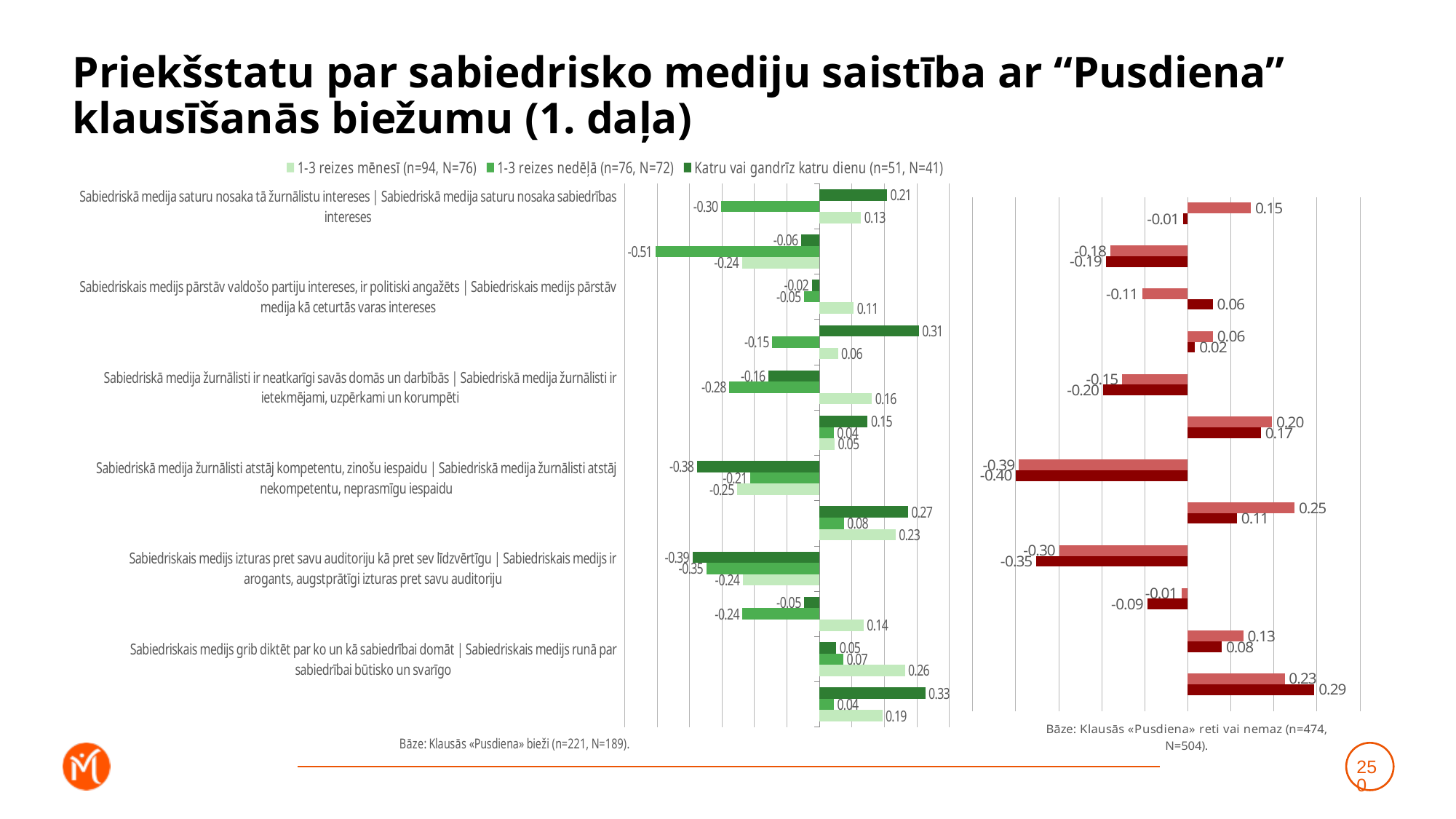
In the green chart on the left, what is the highest value shown on any bar? 0.33 What are the three legend entries of the green chart on the left? 1-3 reizes mēnesī (n=94, N=76); 1-3 reizes nedēļā (n=76, N=72); Katru vai gandrīz katru dienu (n=51, N=41) In the green chart on the left, what is the value of '1-3 reizes mēnesī' for the first category 'Sabiedriskā medija saturu nosaka tā žurnālistu intereses | Sabiedriskā medija saturu nosaka sabiedrības intereses'? 0.13 In the green chart on the left, what is the value of 'Katru vai gandrīz katru dienu' for the first category 'Sabiedriskā medija saturu nosaka tā žurnālistu intereses | Sabiedriskā medija saturu nosaka sabiedrības intereses'? 0.21 In the red chart on the right, what is the lowest value shown on any bar? -0.40 In the green chart on the left, for the first category, how much larger is the 'Katru vai gandrīz katru dienu' value than the '1-3 reizes mēnesī' value? 0.08 What base note is printed under the green chart on the left? Bāze: Klausās «Pusdiena» bieži (n=221, N=189). What kind of chart is the green chart on the left of the slide? bar chart In the red chart on the right, what is the highest value shown on any bar? 0.29 How many series does the legend of the green chart on the left list? 3 In the green chart on the left, what is the value of '1-3 reizes nedēļā' for the first category 'Sabiedriskā medija saturu nosaka tā žurnālistu intereses | Sabiedriskā medija saturu nosaka sabiedrības intereses'? -0.30 In the green chart on the left, what is the lowest value shown on any bar? -0.51